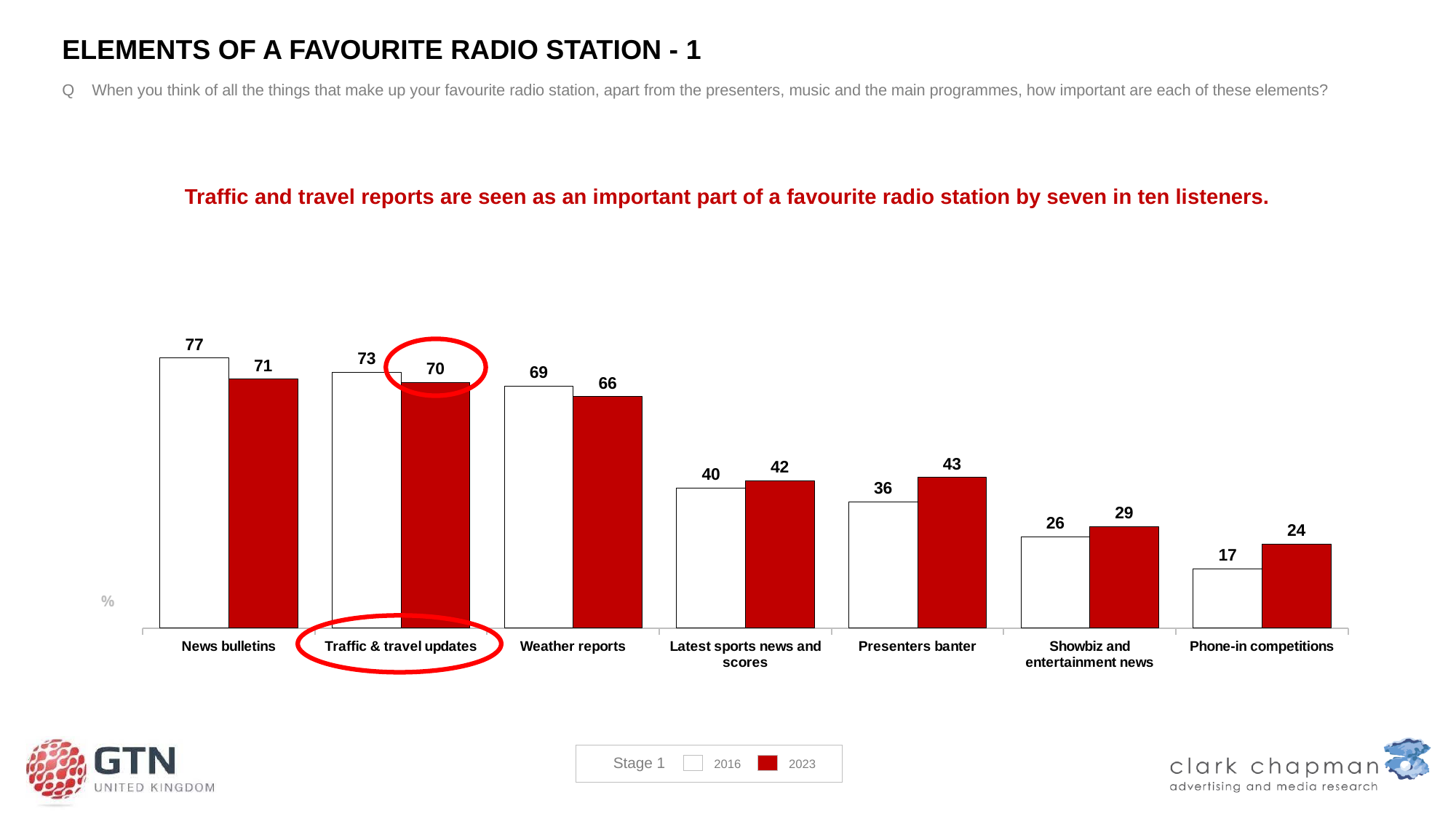
What is the 2023 value for Traffic & travel updates? 70 Which category has the highest 2023 value? News bulletins What is the difference between the 2023 values for Weather reports and Latest sports news and scores? 24 What kind of chart is shown on the slide? Bar chart What is the 2023 value for Phone-in competitions? 24 Which colour represents the 2023 series in the chart? Red What is the difference between the 2016 and 2023 values for News bulletins? 6 Which category has the lowest 2016 value? Phone-in competitions How many series does the legend list? 2 What is the 2016 value for Presenters banter? 36 Which is larger for Presenters banter: the 2016 value or the 2023 value? 2023 How many categories are shown on the x axis? 7